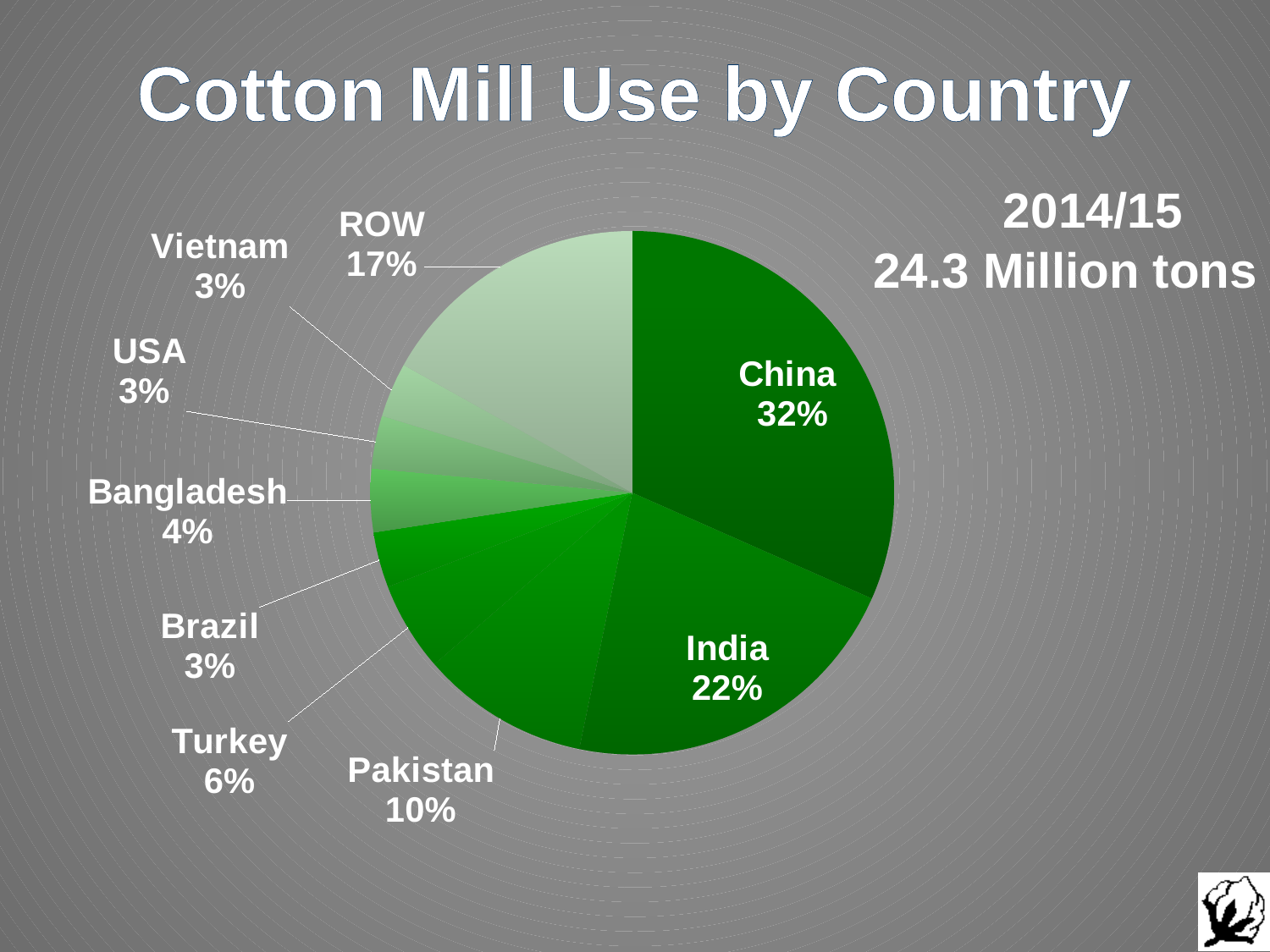
What share of cotton mill use does Turkey account for? 6% What is the difference in percentage points between China's share and India's share? 10 Which country has the largest share of cotton mill use? China What share of cotton mill use does India account for? 22% What share of cotton mill use does ROW (rest of world) account for? 17% What is the title of the chart? Cotton Mill Use by Country What share of cotton mill use does Pakistan account for? 10% What kind of chart is shown on the slide? Pie chart Which has the larger share of cotton mill use, India or Pakistan? India What share of cotton mill use does Bangladesh account for? 4% What share of cotton mill use does China account for? 32% How many slices does the pie chart have? 9